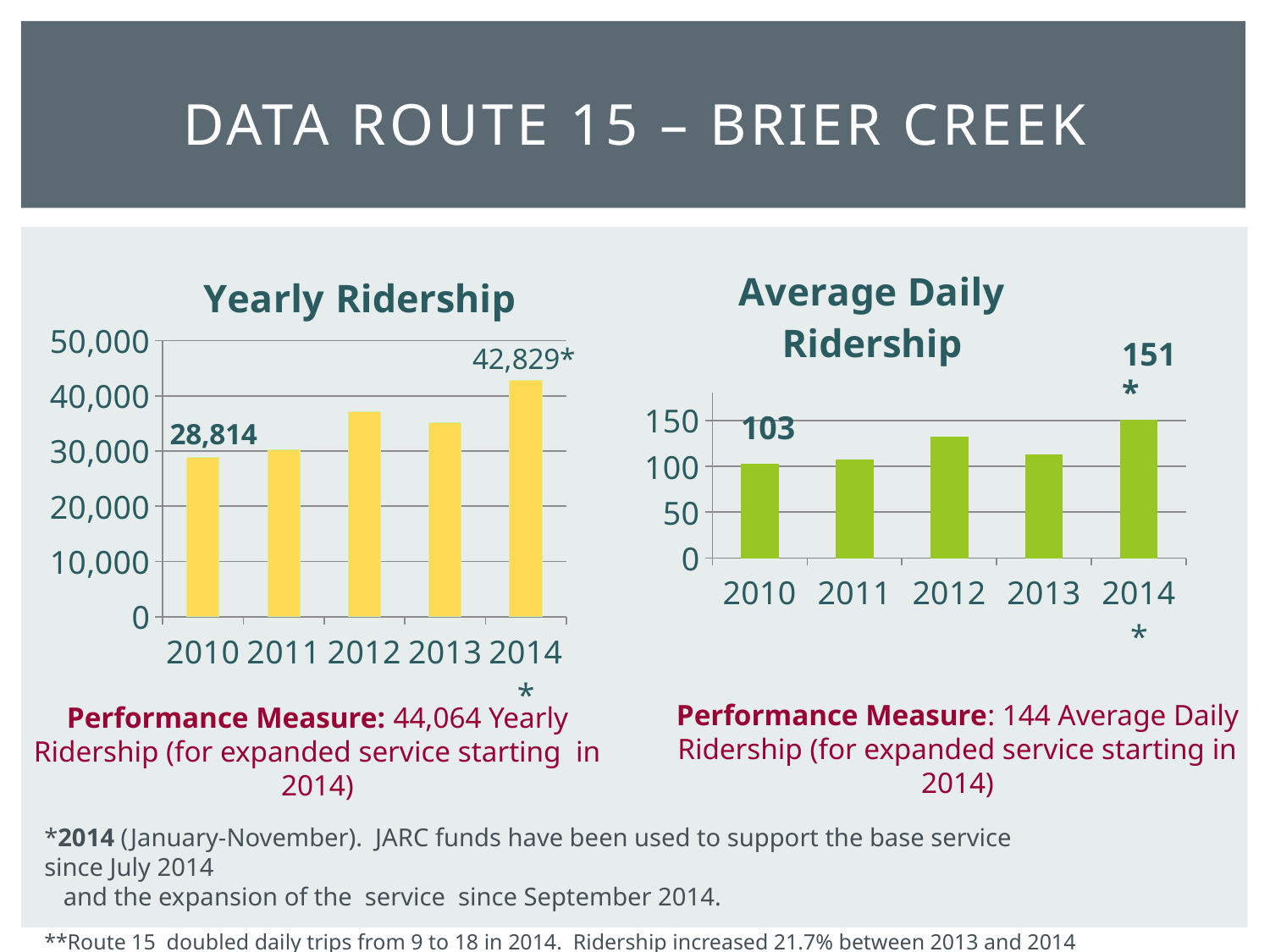
In the Average Daily Ridership chart, what is the difference between the 2014 and 2010 values? 48 In the Average Daily Ridership chart, what is the value for 2014? 151 In the Yearly Ridership chart, what is the value for 2014? 42,829 In the Yearly Ridership chart, which year has the highest ridership? 2014 In the Average Daily Ridership chart, which is larger, the value for 2012 or the value for 2013? 2012 What kind of chart is the Average Daily Ridership chart? Bar chart In the Yearly Ridership chart, what is the difference between the 2014 and 2010 values? 14,015 In the Average Daily Ridership chart, is the value for 2013 greater or less than 100? greater In the Yearly Ridership chart, how many years are shown on the x axis? 5 In the Yearly Ridership chart, what is the value for 2010? 28,814 In the Yearly Ridership chart, is the value for 2012 greater or less than 30,000? greater In the Average Daily Ridership chart, what is the value for 2010? 103